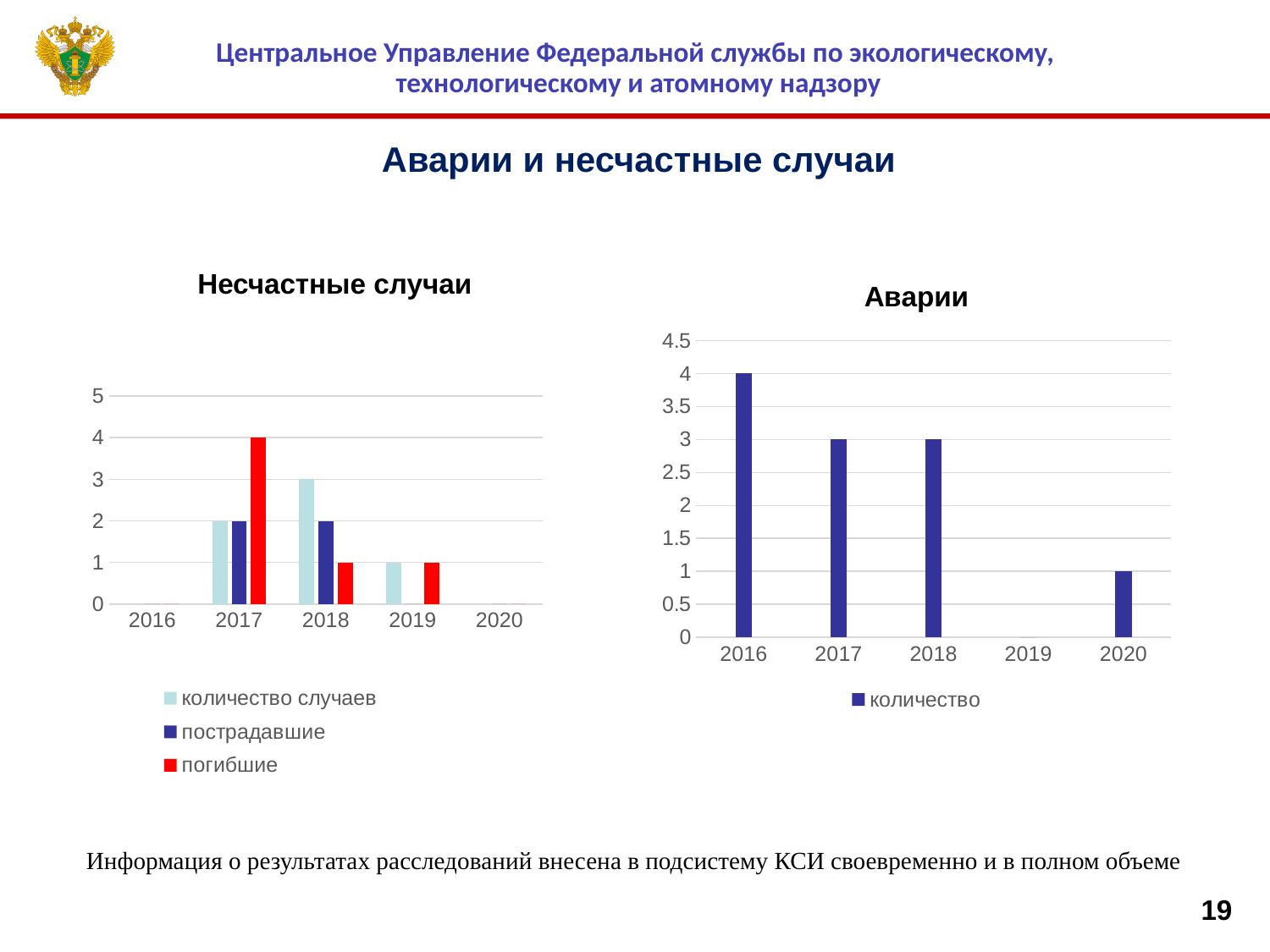
In the "Несчастные случаи" chart, which series is shown in red? погибшие In the "Аварии" chart, what is the value for 2016? 4 In the "Несчастные случаи" chart, what is the value of "погибшие" for 2017? 4 In the "Аварии" chart, what is the difference between the values for 2016 and 2020? 3 In the "Несчастные случаи" chart, how many years are shown on the x axis? 5 In the "Аварии" chart, what is the value for 2020? 1 In the "Аварии" chart, which year has the highest value? 2016 In the "Несчастные случаи" chart, what is the value of "количество случаев" for 2018? 3 In the "Несчастные случаи" chart, how many series does the legend list? 3 In the "Аварии" chart, how many series does the legend list? 1 What kind of chart is the "Аварии" chart? bar chart In the "Несчастные случаи" chart, which is larger for 2018: "количество случаев" or "погибшие"? количество случаев